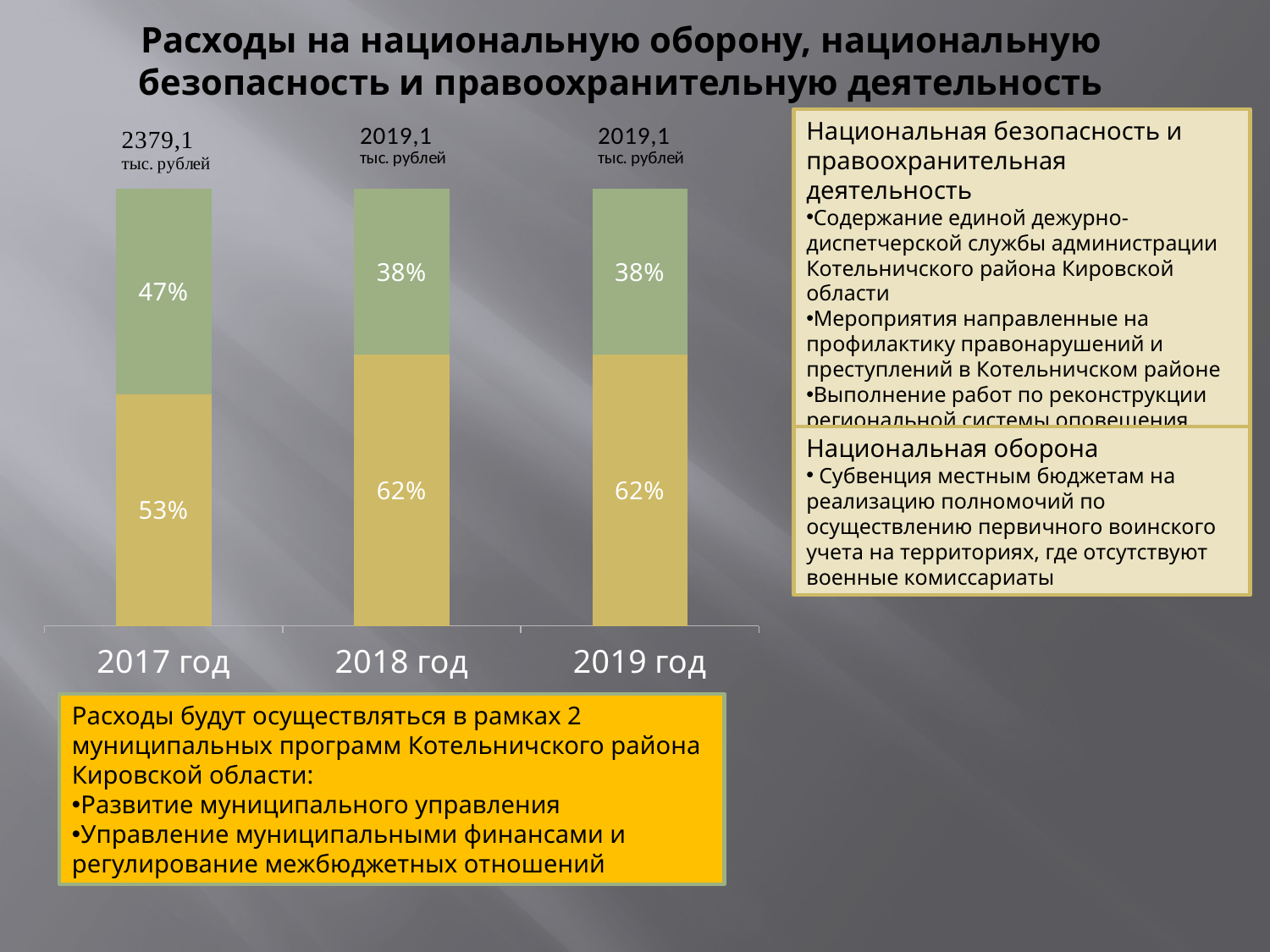
What percentage is shown in the lower (yellow) segment of the 2017 год bar? 53% Does the share of the upper (green) segment rise or fall from 2017 год to 2018 год? fall What total value is printed above the bar for 2017 год? 2379,1 тыс. рублей How many bars (years) are shown in the chart? 3 What total value is printed above the bar for 2018 год? 2019,1 тыс. рублей What kind of chart is shown on the slide? stacked bar chart What percentage is shown in the lower (yellow) segment of the 2018 год bar? 62% What percentage is shown in the upper (green) segment of the 2017 год bar? 47% Which year has the highest total value printed above its bar? 2017 год What percentage is shown in the upper (green) segment of the 2019 год bar? 38% What is the difference between the total for 2017 год and the total for 2018 год? 360,0 тыс. рублей What total value is printed above the bar for 2019 год? 2019,1 тыс. рублей